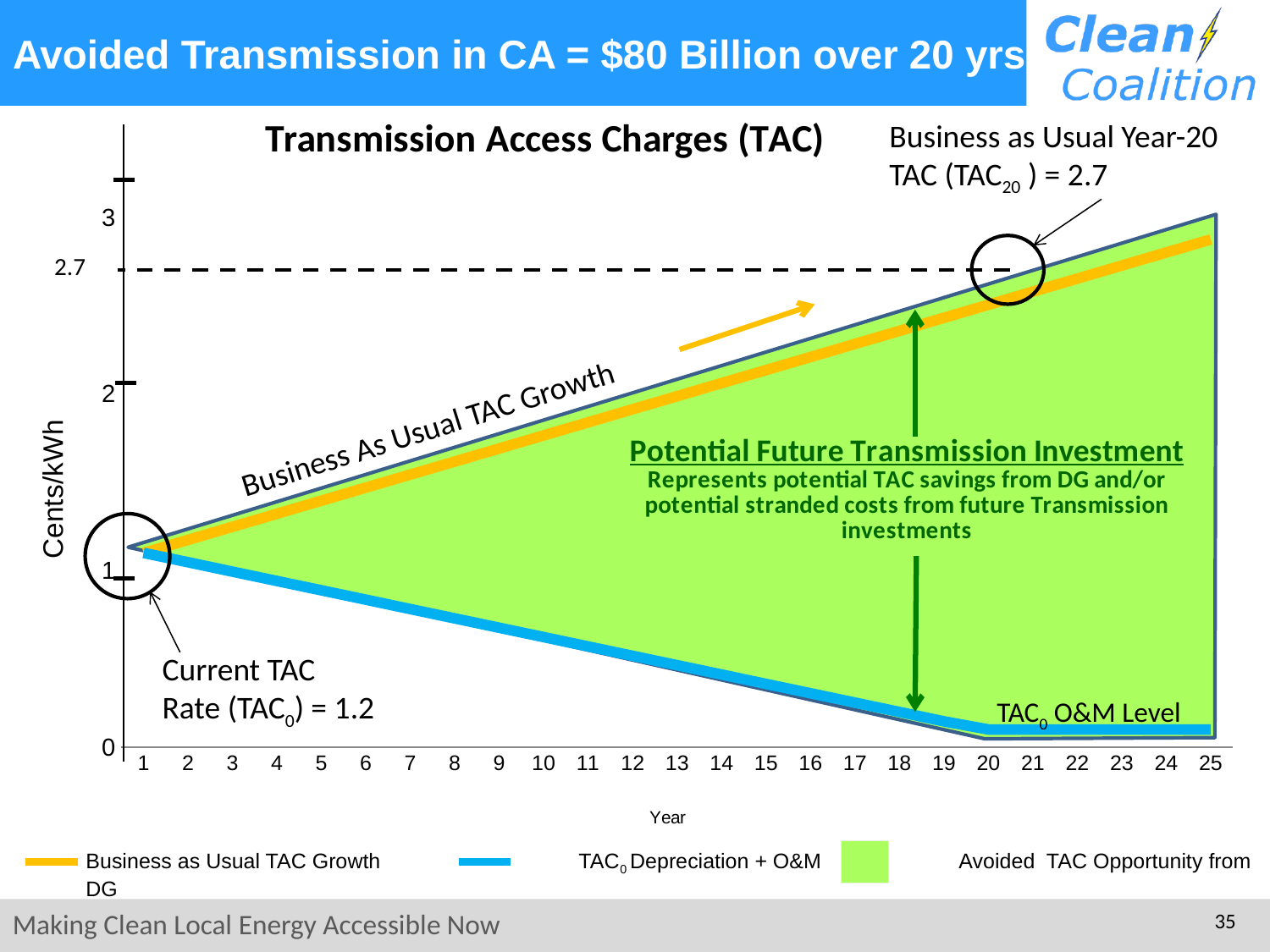
What is the Business as Usual Year-20 TAC (TAC20) according to the annotation on the chart? 2.7 What kind of chart is shown on the slide? line chart What is the title of the chart? Transmission Access Charges (TAC) Does the TAC0 Depreciation + O&M line rise or fall as the years increase? fall At year 20, which is larger: Business as Usual TAC Growth or TAC0 Depreciation + O&M? Business as Usual TAC Growth What unit is shown on the y axis of the chart? Cents/kWh How many years are shown along the x axis? 25 What is the difference between the Business as Usual Year-20 TAC and the Current TAC Rate? 1.5 How many series does the legend list? 3 Does the Business as Usual TAC Growth line rise or fall as the years increase? rise What is the Current TAC Rate (TAC0) according to the annotation on the chart? 1.2 Is the value of TAC0 Depreciation + O&M at year 10 greater or less than 1? less